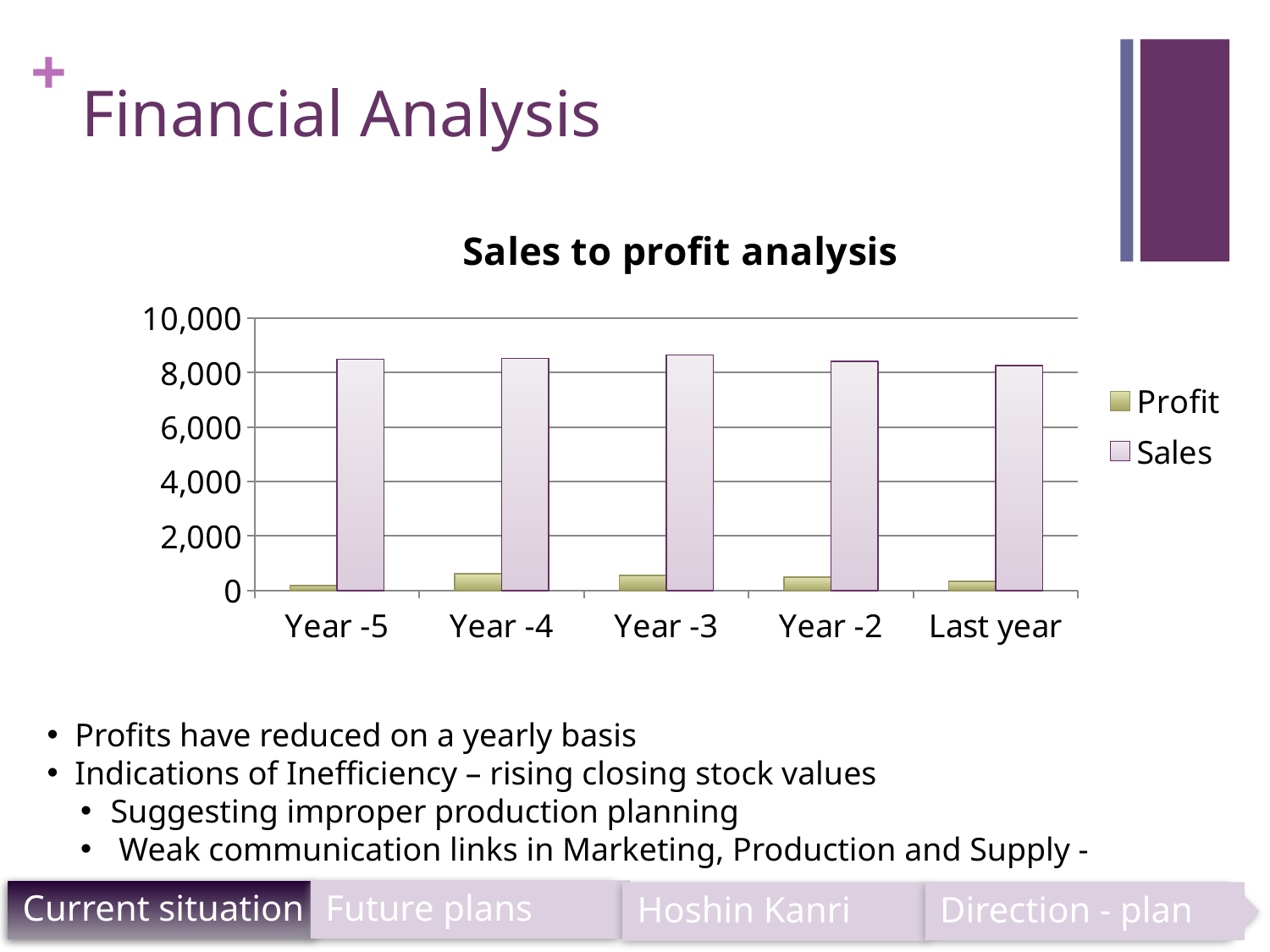
Which year has the lowest Profit value? Year -5 What is the title of the chart? Sales to profit analysis Which is larger for Year -2, Profit or Sales? Sales Which series is shown in the lighter purple bars? Sales Is the Sales value for Last year greater or less than 10,000? less Is the Sales value for Year -5 greater or less than 8,000? greater How many series does the chart's legend list? 2 What kind of chart is shown on the slide? bar chart Which is larger, the Sales for Year -3 or the Sales for Last year? Year -3 How many year categories are shown on the x axis of the chart? 5 Is the Profit value for Year -4 greater or less than 2,000? less Which is larger, the Profit for Year -5 or the Profit for Year -4? Year -4